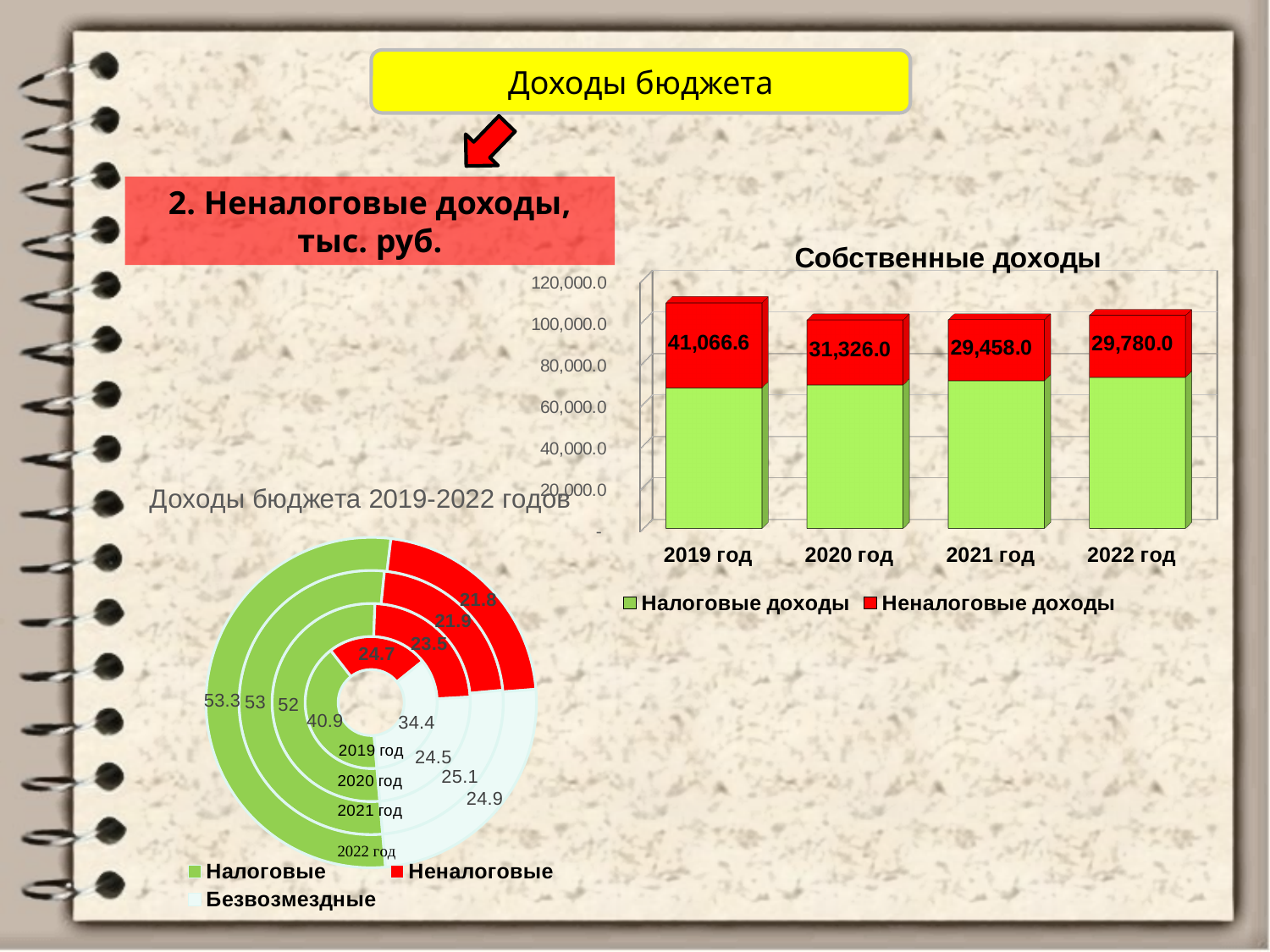
In the 'Собственные доходы' chart, do the Неналоговые доходы values rise or fall from 2019 год to 2021 год? fall In the 'Собственные доходы' chart, what is the value of Неналоговые доходы for 2019 год? 41,066.6 How many years are shown on the x axis of the 'Собственные доходы' chart? 4 How many series does the legend of the 'Собственные доходы' chart list? 2 What kind of chart is 'Собственные доходы'? Stacked bar chart In the 'Собственные доходы' chart, which year has the highest Неналоговые доходы value? 2019 год In the 'Собственные доходы' chart, which is larger: Неналоговые доходы for 2021 год or for 2022 год? 2022 год In the 'Собственные доходы' chart, is the total height of the 2019 год bar greater or less than 100,000.0? greater In the 'Собственные доходы' chart, what is the difference between the Неналоговые доходы values for 2019 год and 2020 год? 9,740.6 In the 'Собственные доходы' chart, which year has the lowest Неналоговые доходы value? 2021 год How many series does the legend of the 'Доходы бюджета 2019-2022 годов' chart list? 3 In the 'Собственные доходы' chart, what is the value of Неналоговые доходы for 2021 год? 29,458.0